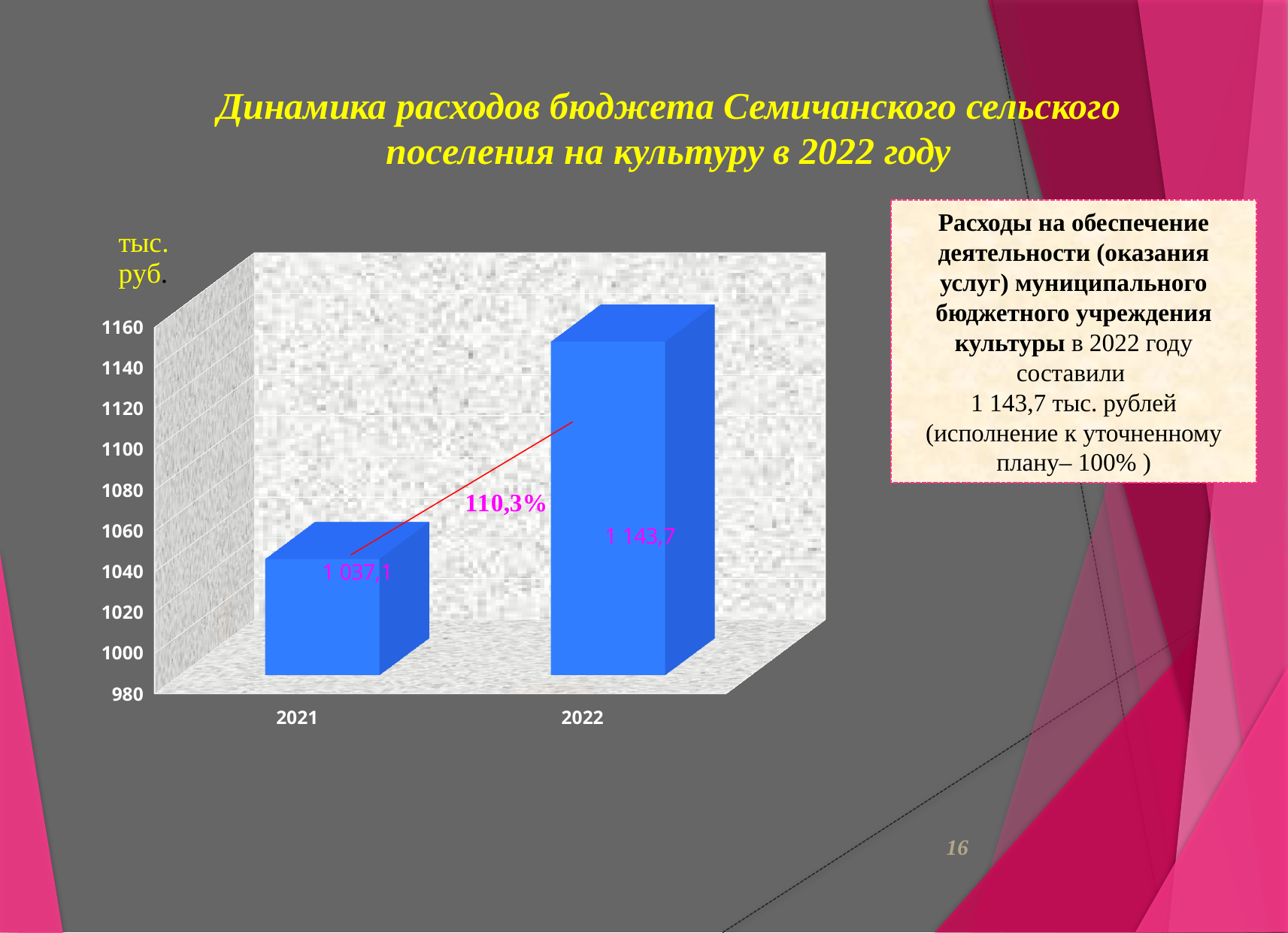
Is the value for 2022 larger than the value for 2021? Yes Which year has the lower value? 2021 How many years (categories) are shown on the chart? 2 What is the value for 2022? 1 143,7 What is the difference between the 2022 and 2021 values? 106,6 What is the value for 2021? 1 037,1 Which year has the higher value? 2022 Is the value for 2022 greater or less than 1100? greater What kind of chart is shown on the slide? Bar chart What percentage is written next to the red line between the two bars? 110,3% Do the values rise or fall from 2021 to 2022? Rise Is the value for 2021 greater or less than 1060? less